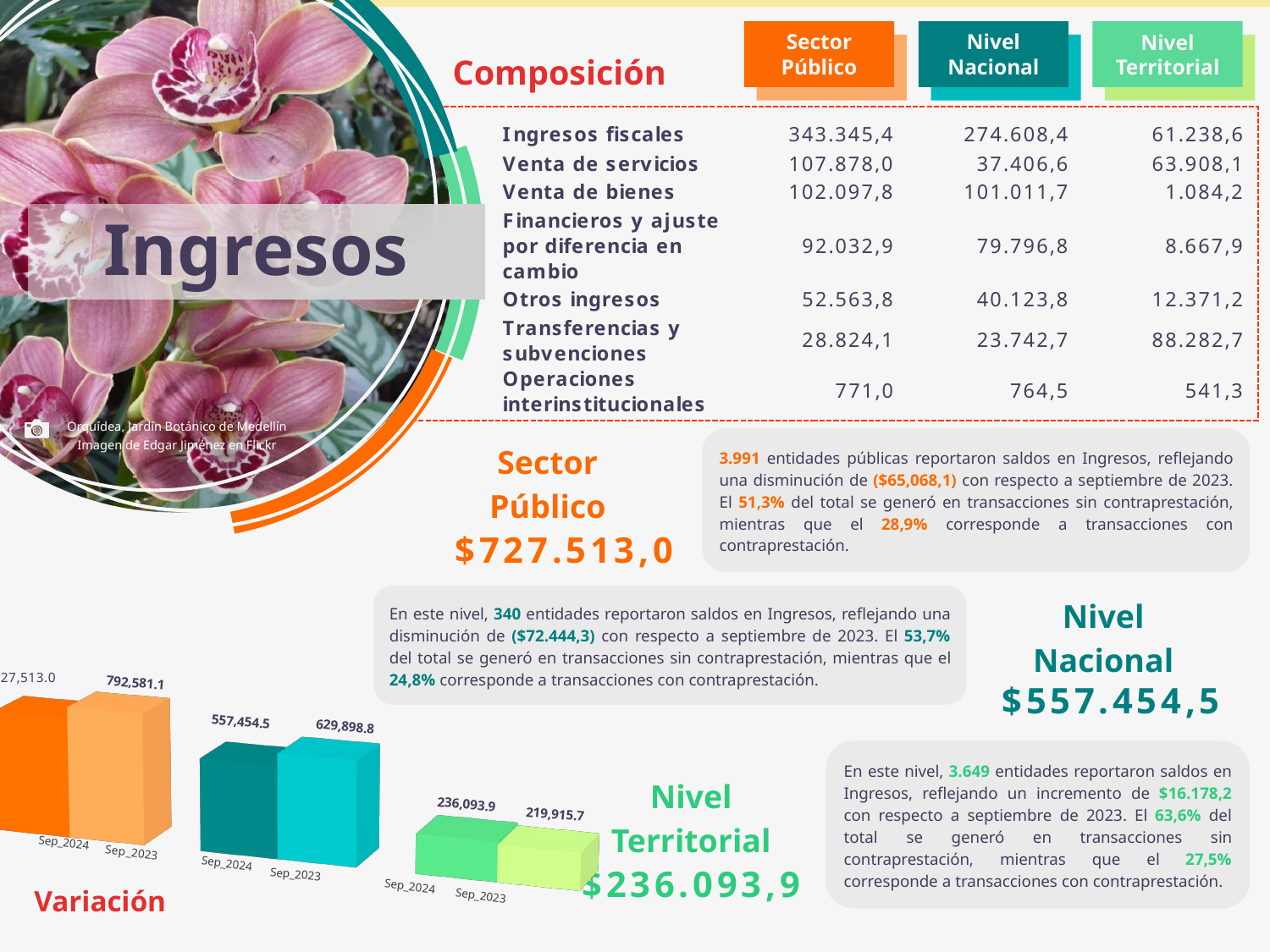
In the Variación chart, what colour are the bars for Nivel Territorial? Green In the Variación chart, what is the value for Sector Público in Sep_2023? 792,581.1 In the Variación chart, what is the value for Nivel Territorial in Sep_2023? 219,915.7 In the Variación chart, what is the value for Nivel Nacional in Sep_2023? 629,898.8 In the Variación chart, which period has the larger value for Nivel Nacional, Sep_2024 or Sep_2023? Sep_2023 In the Variación chart, what is the value for Nivel Territorial in Sep_2024? 236,093.9 What kind of chart is the Variación chart? Bar chart In the Variación chart, which level has the highest Sep_2023 value? Sector Público In the Variación chart, what is the value for Nivel Nacional in Sep_2024? 557,454.5 In the Variación chart, which period has the larger value for Nivel Territorial, Sep_2024 or Sep_2023? Sep_2024 In the Variación chart, what is the difference between the Sep_2024 and Sep_2023 values for Nivel Territorial? 16,178.2 In the Variación chart, what is the difference between the Sep_2023 and Sep_2024 values for Nivel Nacional? 72,444.3